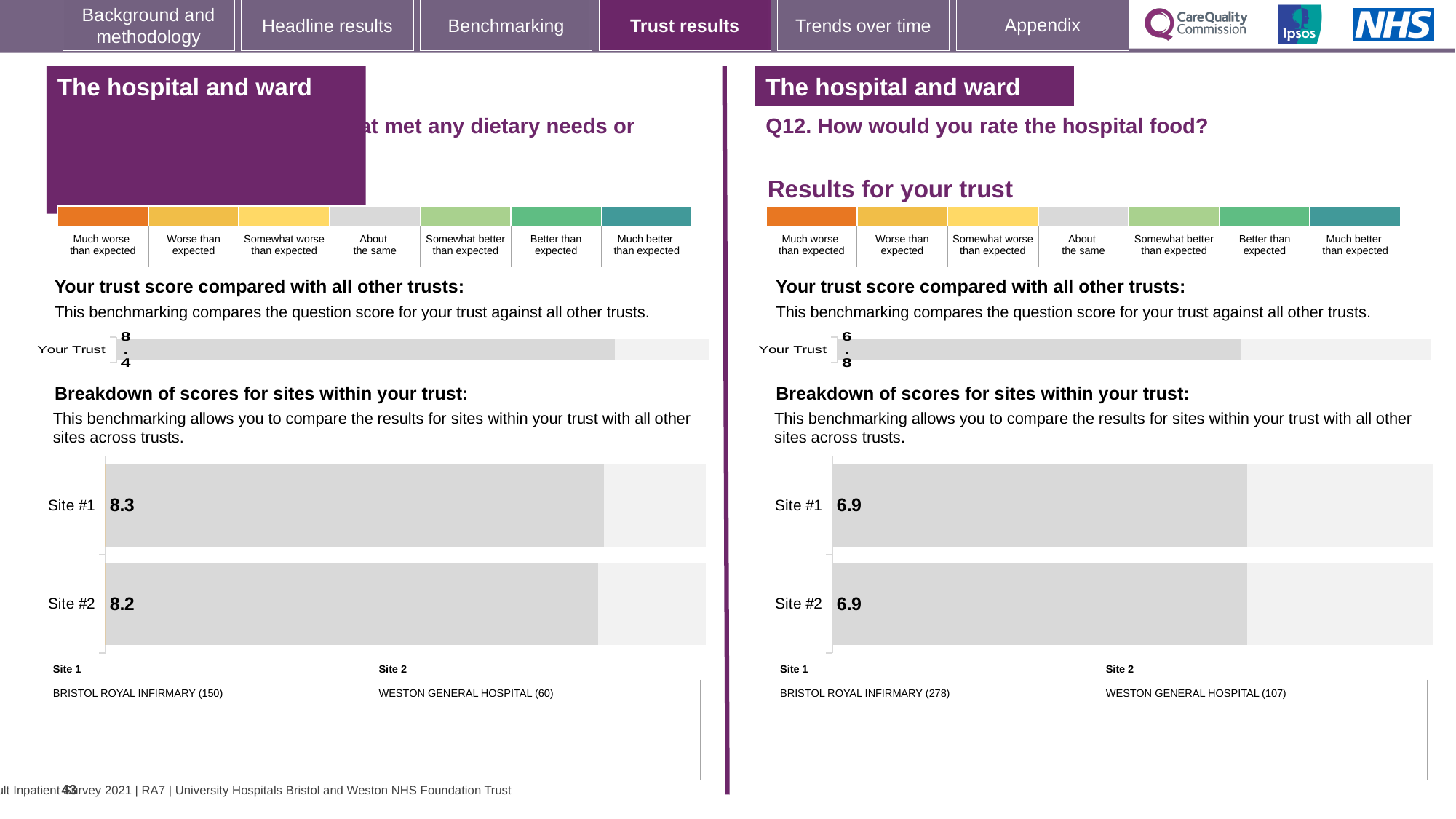
On the right-hand chart (Q12, hospital food), what is the 'Your Trust' score compared with all other trusts? 6.8 On the left-hand chart, what is the 'Your Trust' score compared with all other trusts? 8.4 On the right-hand chart (Q12, hospital food), what is the difference between the Site #1 and Site #2 scores? 0 According to the key below the right-hand chart (Q12), which hospital is Site 1? BRISTOL ROYAL INFIRMARY How many sites are shown in the breakdown of scores on the right-hand chart (Q12)? 2 On the left-hand chart, which site has the higher score, Site #1 or Site #2? Site #1 On the right-hand chart (Q12, hospital food), what is the score for Site #1 in the breakdown of scores for sites? 6.9 On the left-hand chart, what is the score shown for Site #1 in the breakdown of scores for sites? 8.3 What kind of chart is used to show the breakdown of scores for sites on the right-hand side of the slide? Bar chart On the right-hand chart (Q12, hospital food), what is the score for Site #2? 6.9 On the left-hand chart, what is the difference between the Site #1 score and the Site #2 score? 0.1 On the left-hand chart, what is the score shown for Site #2? 8.2